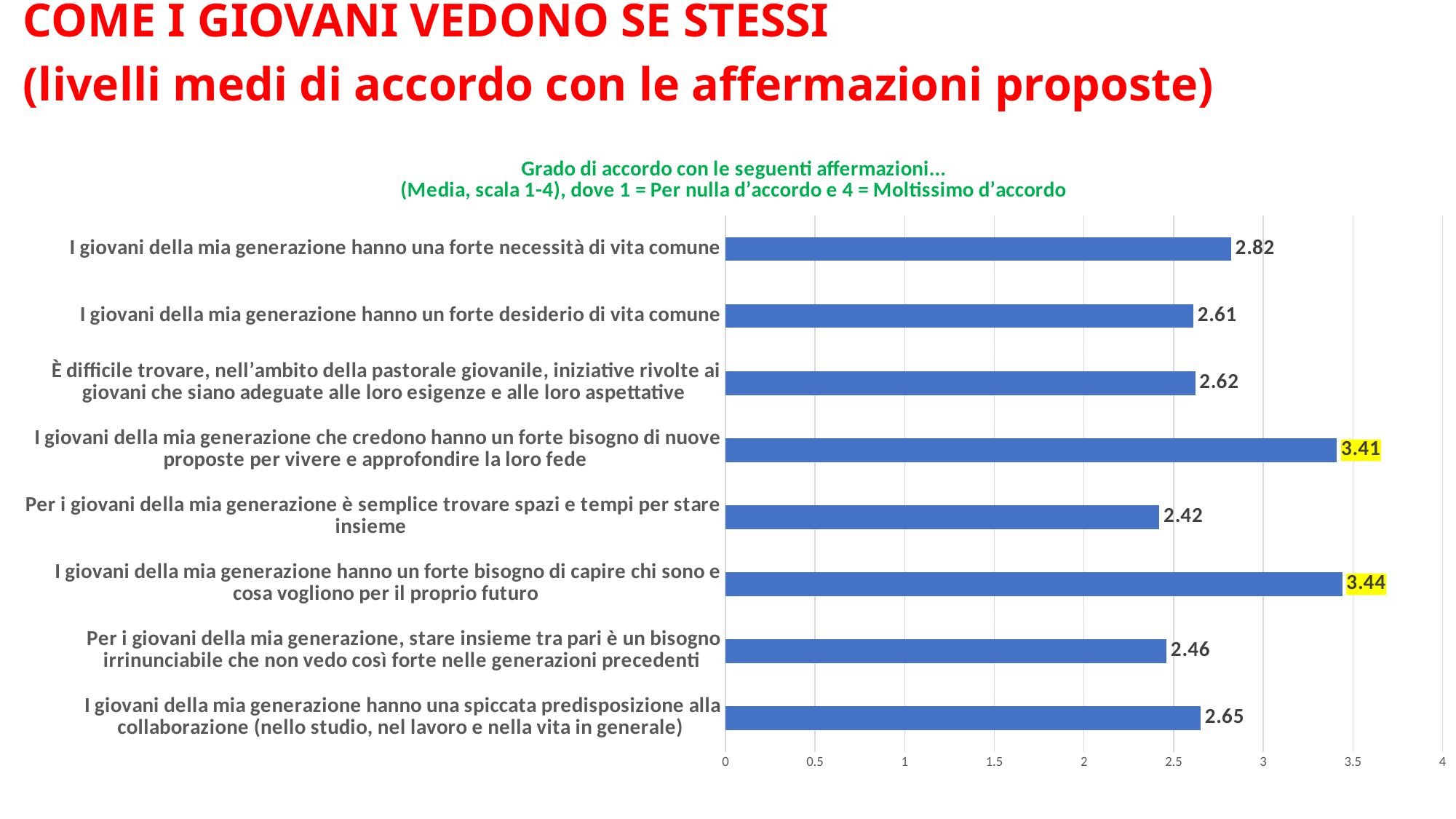
Which statement has the lowest mean agreement value? Per i giovani della mia generazione è semplice trovare spazi e tempi per stare insieme Which has a larger value: "...hanno una forte necessità di vita comune" or "...stare insieme tra pari è un bisogno irrinunciabile che non vedo così forte nelle generazioni precedenti"? I giovani della mia generazione hanno una forte necessità di vita comune What kind of chart is shown on the slide? bar chart How many statements (categories) are plotted in the chart? 8 What is the difference between the values for "...hanno una forte necessità di vita comune" and "...hanno un forte desiderio di vita comune"? 0.21 What is the value shown for "I giovani della mia generazione hanno una spiccata predisposizione alla collaborazione (nello studio, nel lavoro e nella vita in generale)"? 2.65 Is the value for "Per i giovani della mia generazione, stare insieme tra pari è un bisogno irrinunciabile..." greater or less than 3? less What is the difference between the values for "...hanno un forte bisogno di capire chi sono e cosa vogliono per il proprio futuro" (3.44) and "...che credono hanno un forte bisogno di nuove proposte per vivere e approfondire la loro fede" (3.41)? 0.03 What is the mean agreement value for "I giovani della mia generazione hanno una forte necessità di vita comune"? 2.82 What is the value shown for "Per i giovani della mia generazione è semplice trovare spazi e tempi per stare insieme"? 2.42 Which two data labels are highlighted in yellow on the chart? 3.41 and 3.44 Which statement has the highest mean agreement value? I giovani della mia generazione hanno un forte bisogno di capire chi sono e cosa vogliono per il proprio futuro